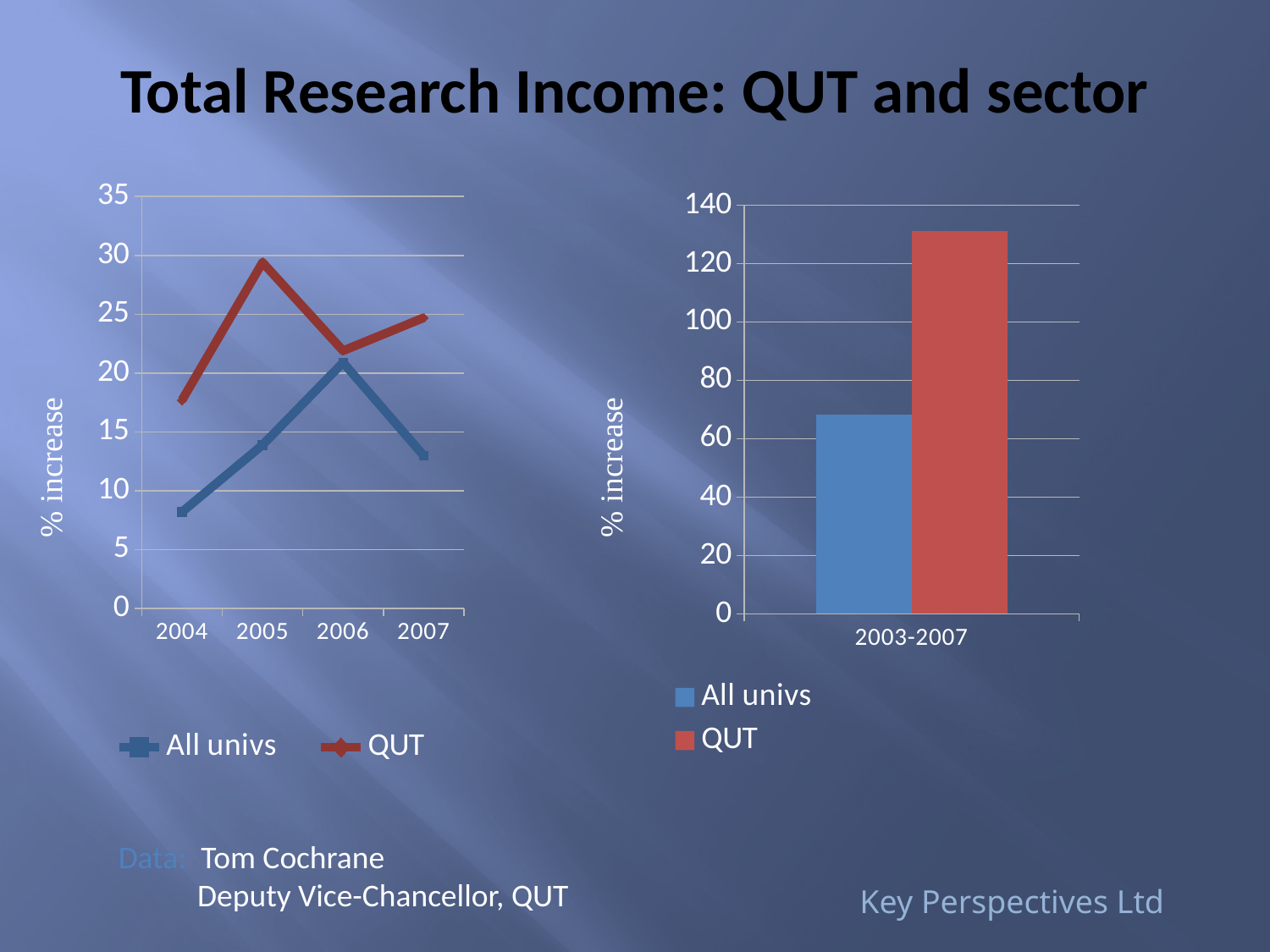
What kind of chart is the right chart on the slide? bar chart In the left chart, how many years are shown on the x axis? 4 In the right chart, is the value for All univs greater or less than 80? less In the right chart, is the value for QUT greater or less than 120? greater In the left chart, is the QUT value for 2005 greater or less than 25? greater In the left chart, does the All univs series rise or fall from 2004 to 2006? rise In the left chart, in which year is the All univs value lowest? 2004 What kind of chart is the left chart on the slide? line chart In the left chart, in which year is the QUT value highest? 2005 In the left chart, which series has the larger value in 2005, All univs or QUT? QUT In the left chart, how many series does the legend list? 2 In the right chart, which bar is taller, All univs or QUT? QUT